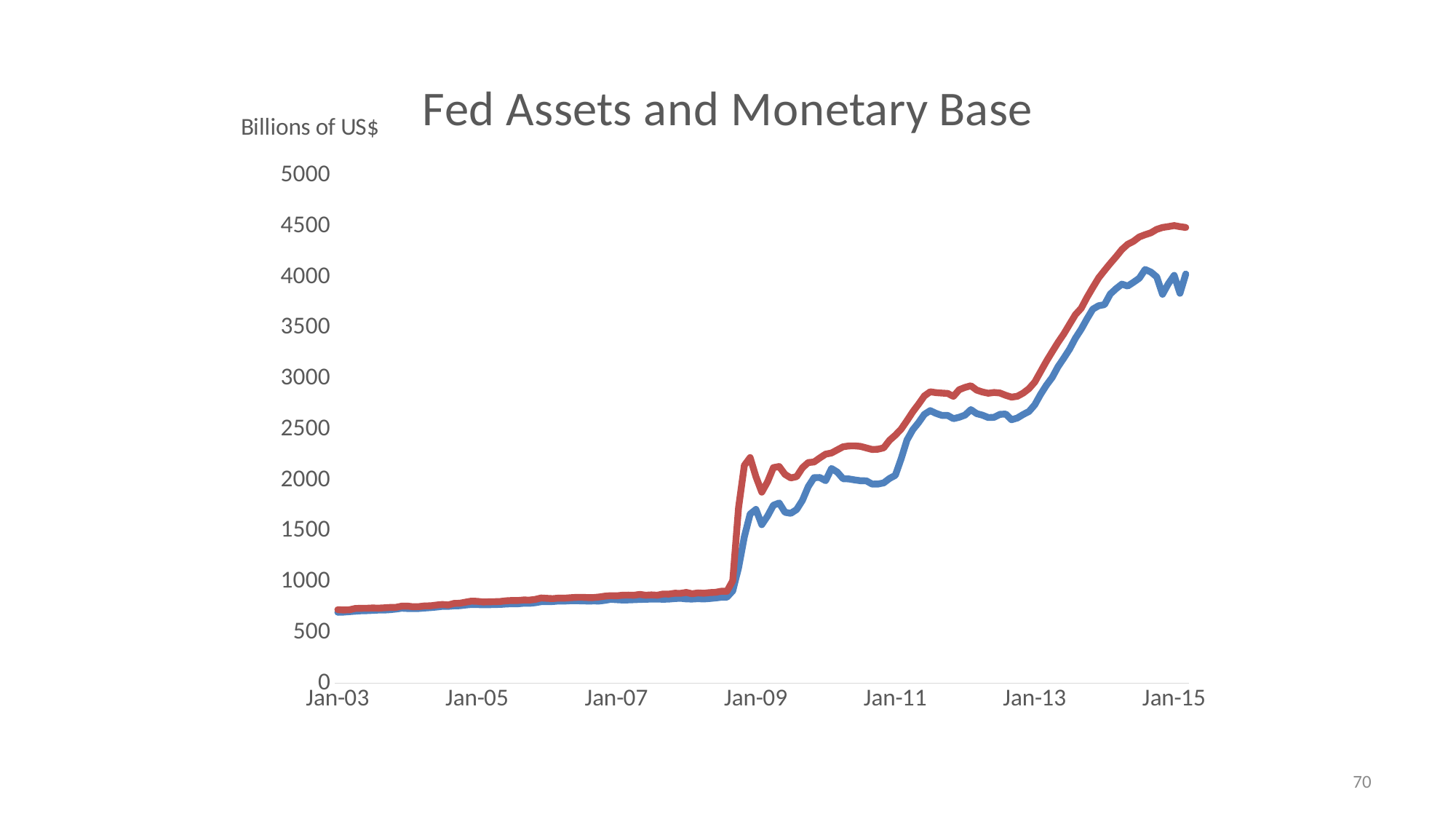
What kind of chart is shown on the slide? line chart What is the highest value labelled on the vertical axis? 5000 What unit label is shown on the vertical axis of the chart? Billions of US$ Overall, do the plotted values rise or fall from Jan-03 to Jan-15? rise How many date labels are shown along the x axis? 7 Is the value of the red line at Jan-07 greater or less than 1000? less Which line is higher at Jan-15, the red line or the blue line? the red line Is the value of the red line at Jan-15 greater or less than 4000? greater How many lines are plotted on the chart? 2 What is the title of the chart? Fed Assets and Monetary Base Is the value of the blue line at Jan-11 greater or less than 2500? less